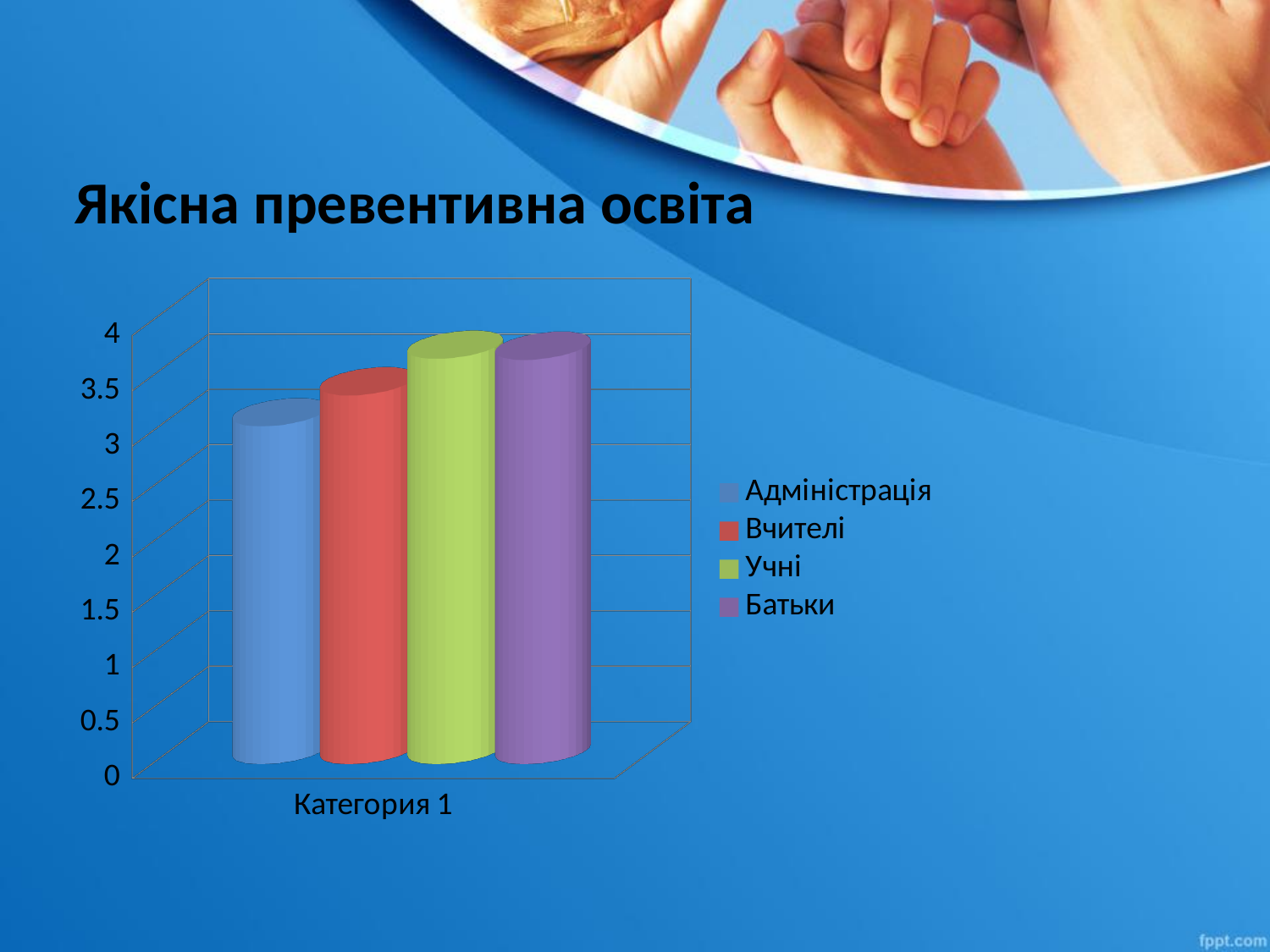
How many categories are shown on the x axis? 1 What is the label of the category on the x axis? Категория 1 Which series has the lowest value? Адміністрація Is the value for Батьки greater or less than 3.5? greater Is the value for Вчителі greater or less than 3? greater What is the title of the slide above the chart? Якісна превентивна освіта Is the value for Учні greater or less than 3.5? greater Which is larger, the value for Адміністрація or the value for Учні? Учні How many series does the legend list? 4 What kind of chart is shown on the slide? bar chart